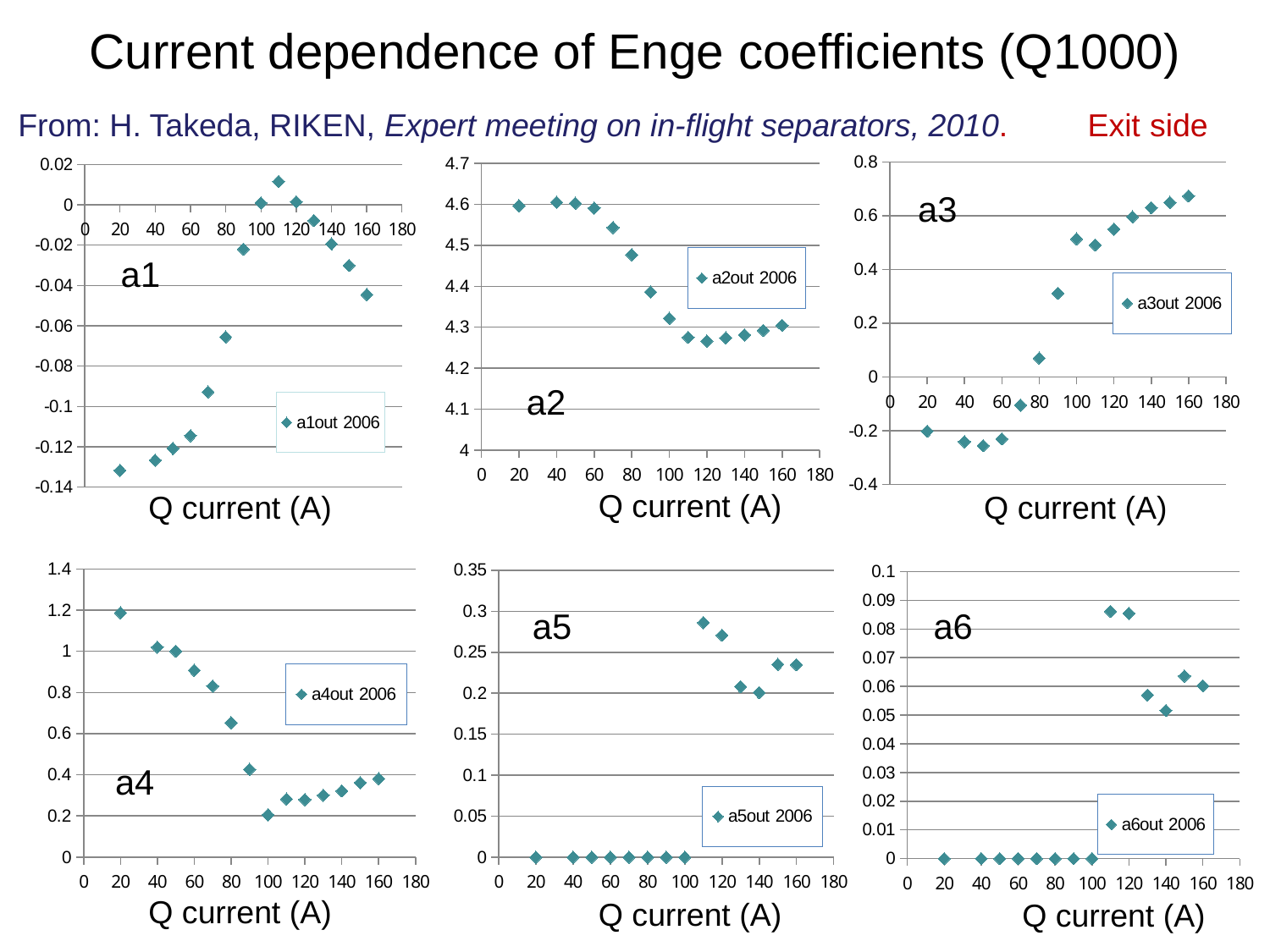
In the a2 chart, is the value at 20 A greater or less than 4.5? greater In the a5 chart, what is the value at a Q current of 20 A? 0 In the a4 chart, at which Q current is the value highest? 20 A In the a6 chart, which is larger: the value at 110 A or the value at 140 A? 110 A In the a3 chart, is the value at 160 A greater or less than 0.6? greater What is the legend entry shown in the a3 chart? a3out 2006 In the a1 chart, is the value at 20 A greater or less than -0.12? less In the a4 chart, at which Q current is the value lowest? 100 A What kind of chart is the a1 chart? scatter chart How many charts are shown on the slide? 6 In the a6 chart, what is the value at a Q current of 60 A? 0 In the a2 chart, do the values rise or fall as the Q current increases from 20 A to 120 A? fall